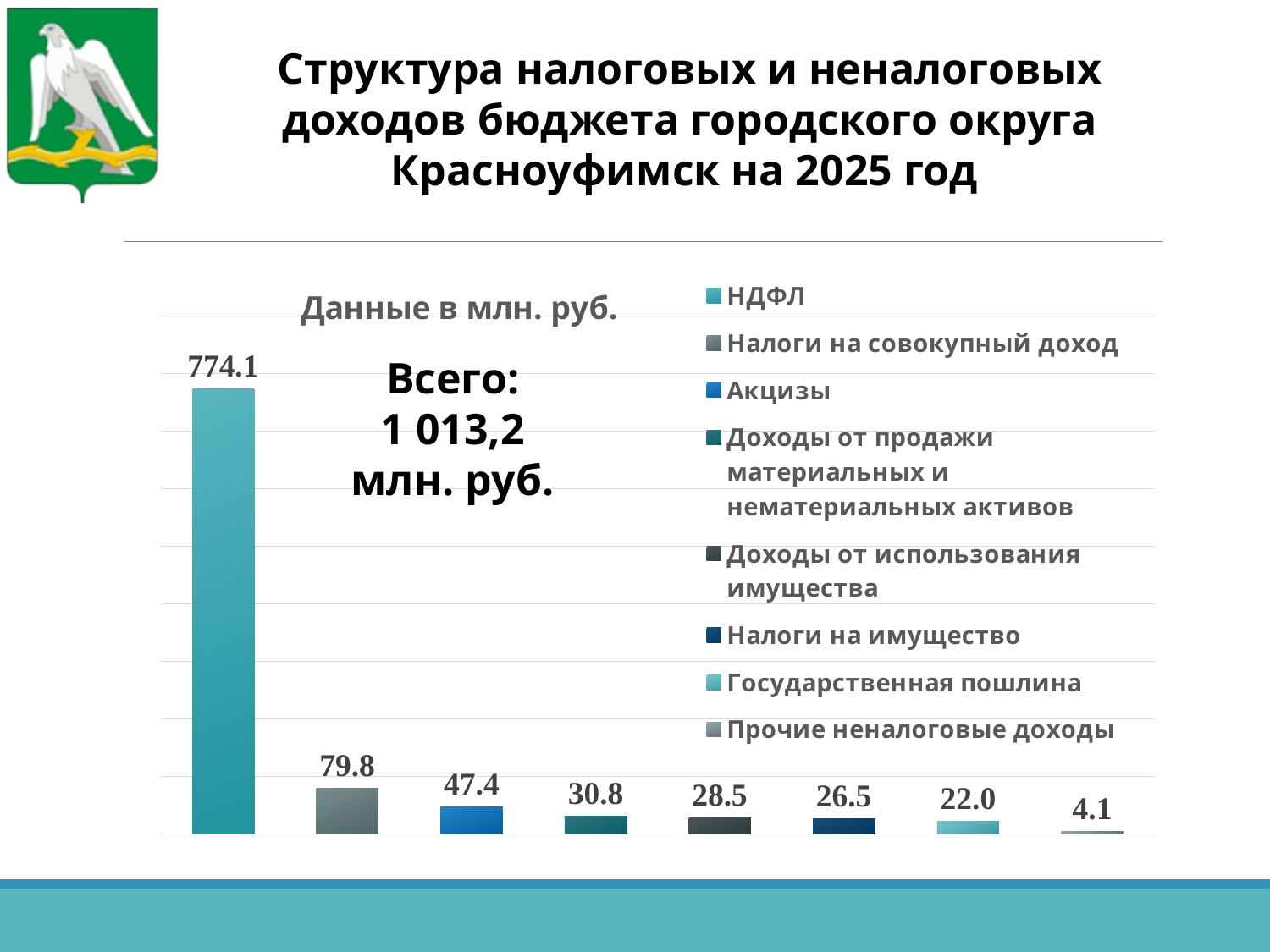
How many bars are plotted in the chart? 8 What is the value for Налоги на совокупный доход? 79.8 Which category has the lowest value? Прочие неналоговые доходы What is the difference between the values for НДФЛ and Налоги на совокупный доход? 694.3 What is the value for НДФЛ? 774.1 Which is larger, the value for Акцизы or the value for Налоги на имущество? Акцизы Which category has the highest value? НДФЛ What is the value for Государственная пошлина? 22.0 What is the value for Акцизы? 47.4 What is the value for Прочие неналоговые доходы? 4.1 How many entries does the legend list? 8 What kind of chart is shown on the slide? Bar chart